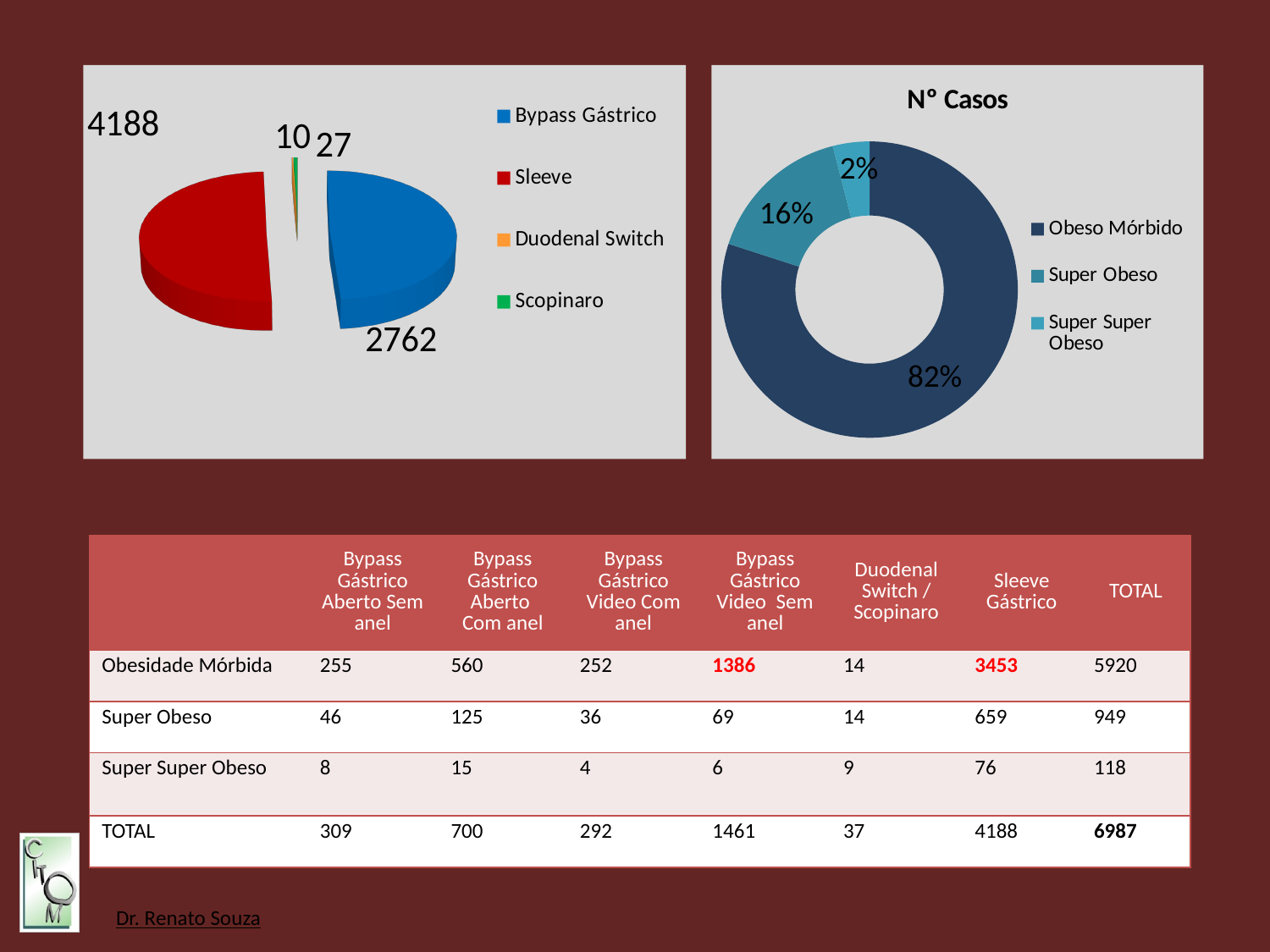
In the left pie chart, what is the difference between the Sleeve value and the Bypass Gástrico value? 1426 In the left pie chart, what is the value for Bypass Gástrico? 2762 How many categories are shown in the chart titled N° Casos? 3 In the chart titled N° Casos, what share does Super Obeso have? 16% In the chart titled N° Casos, what share does Obeso Mórbido have? 82% In the left pie chart, what is the value for Sleeve? 4188 What is the title of the right-hand chart? N° Casos In the left pie chart, which is larger, Sleeve or Bypass Gástrico? Sleeve In the chart titled N° Casos, which category has the smallest share? Super Super Obeso What kind of chart is the left chart? Pie chart How many entries does the legend of the left pie chart list? 4 In the left pie chart, which category has the largest slice? Sleeve